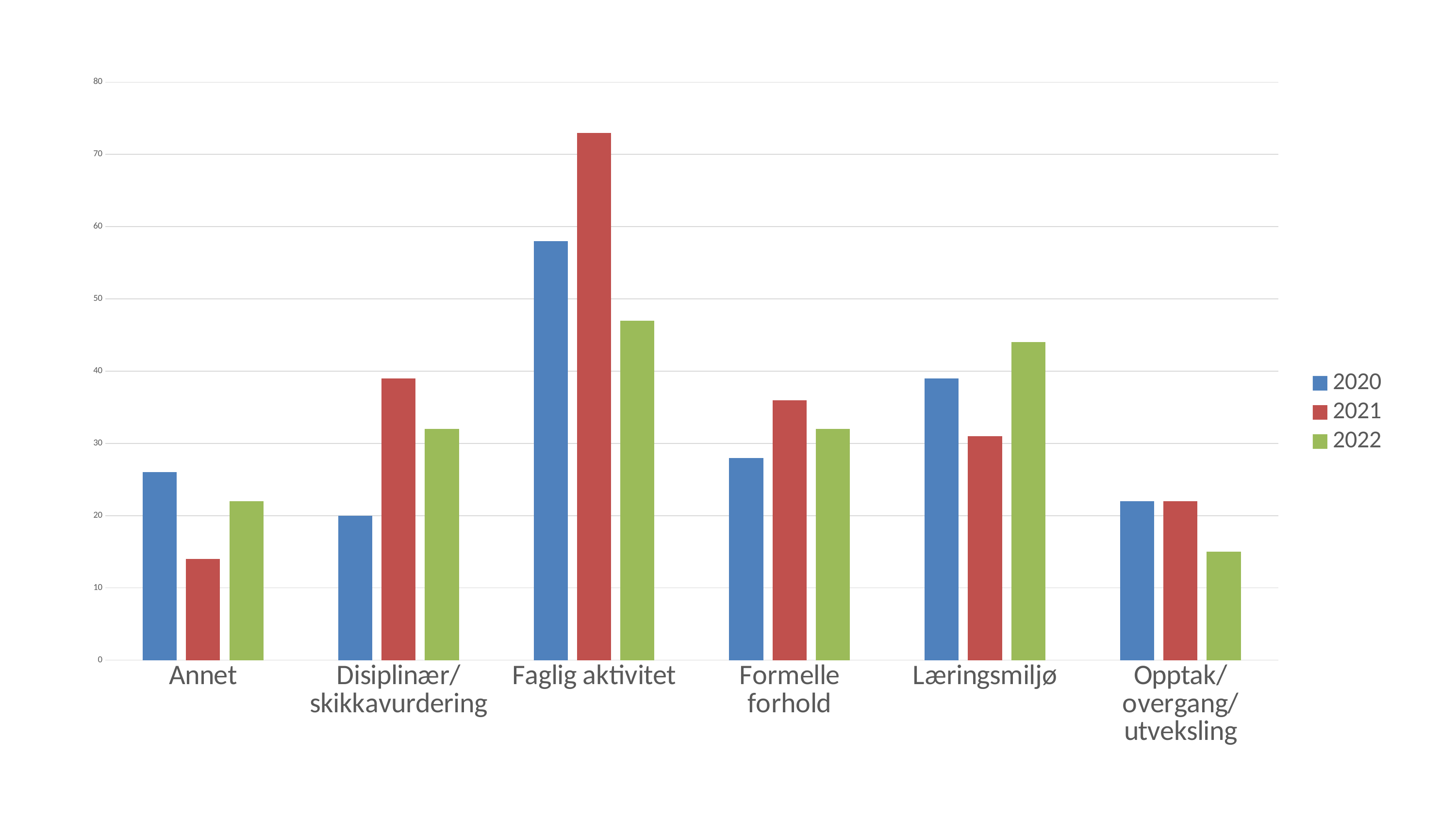
Which category has the highest 2021 value? Faglig aktivitet Which category has the lowest 2021 value? Annet What kind of chart is shown on the slide? bar chart How many series does the legend list? 3 Which category has the lowest 2022 value? Opptak/overgang/utveksling Is the 2022 value for Læringsmiljø greater or less than 40? greater For Læringsmiljø, which is larger: the 2020 value or the 2021 value? 2020 Is the 2021 value for Faglig aktivitet greater or less than 70? greater How many categories are shown on the x axis? 6 Is the 2021 value for Annet greater or less than 20? less Which series is shown in green in the legend? 2022 Which category has the highest 2020 value? Faglig aktivitet